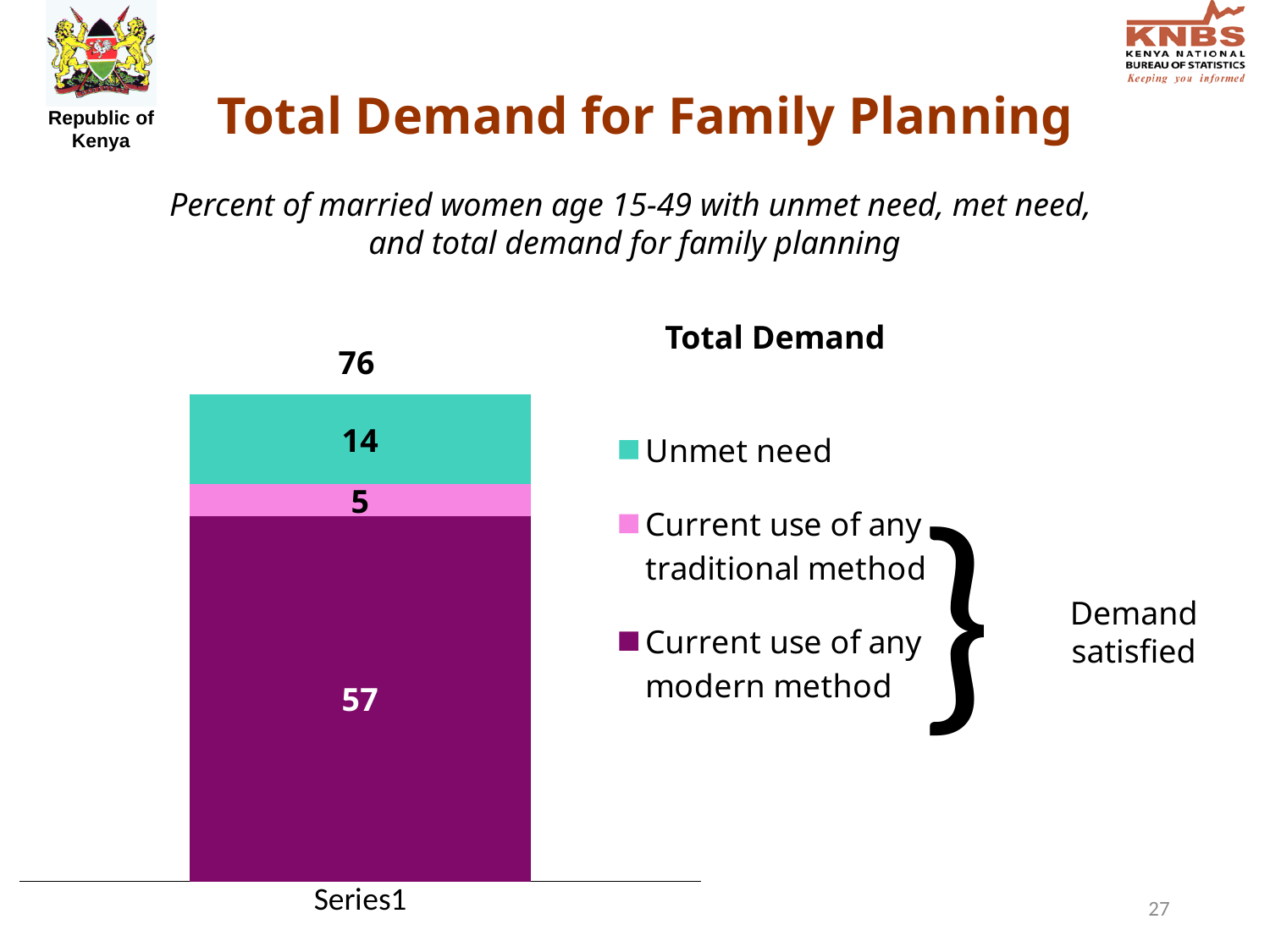
What is the difference between Unmet need and Current use of any traditional method? 9 What is the value for Current use of any traditional method? 5 What is the value for Current use of any modern method? 57 What is the total of the stacked bar? 76 Which segment of the stacked bar has the smallest value? Current use of any traditional method Which is larger, Unmet need or Current use of any traditional method? Unmet need How many series does the legend list? 3 What kind of chart is shown on the slide? Stacked bar chart What is the difference between Current use of any modern method and Unmet need? 43 What is the value for Unmet need in the stacked bar? 14 Which segment of the stacked bar has the largest value? Current use of any modern method What is the title of the chart? Total Demand